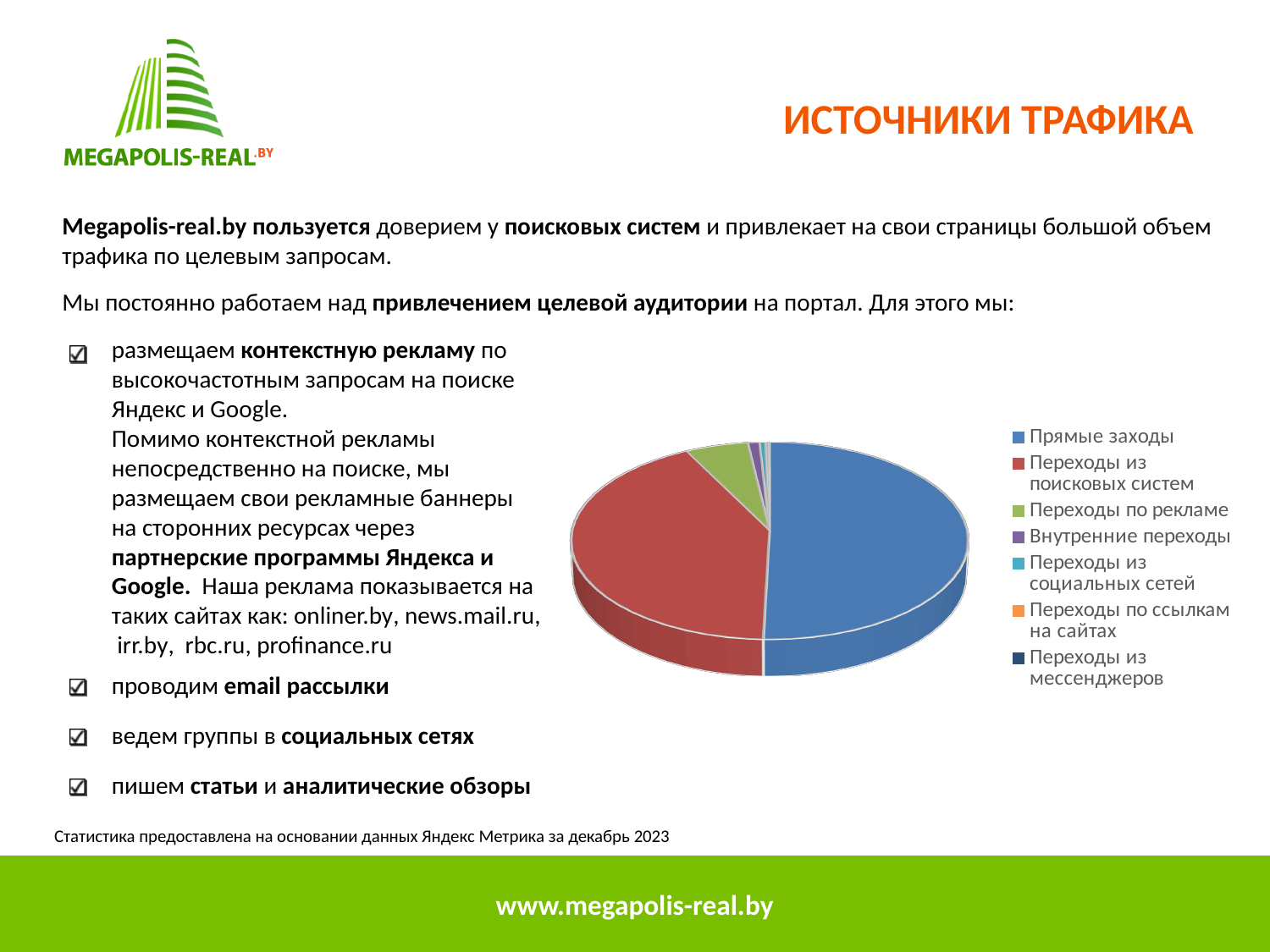
Which traffic source has the largest slice in the pie chart? Прямые заходы Which slice is larger: Переходы из поисковых систем or Переходы по рекламе? Переходы из поисковых систем What colour is the slice for Прямые заходы in the pie chart? blue How many categories does the legend of the pie chart list? 7 Which traffic source has the second-largest slice in the pie chart? Переходы из поисковых систем Which slice is larger: Прямые заходы or Переходы из поисковых систем? Прямые заходы What kind of chart is shown on the slide? pie chart Which slice is larger: Переходы по рекламе or Внутренние переходы? Переходы по рекламе What is the title of the slide containing the pie chart? ИСТОЧНИКИ ТРАФИКА